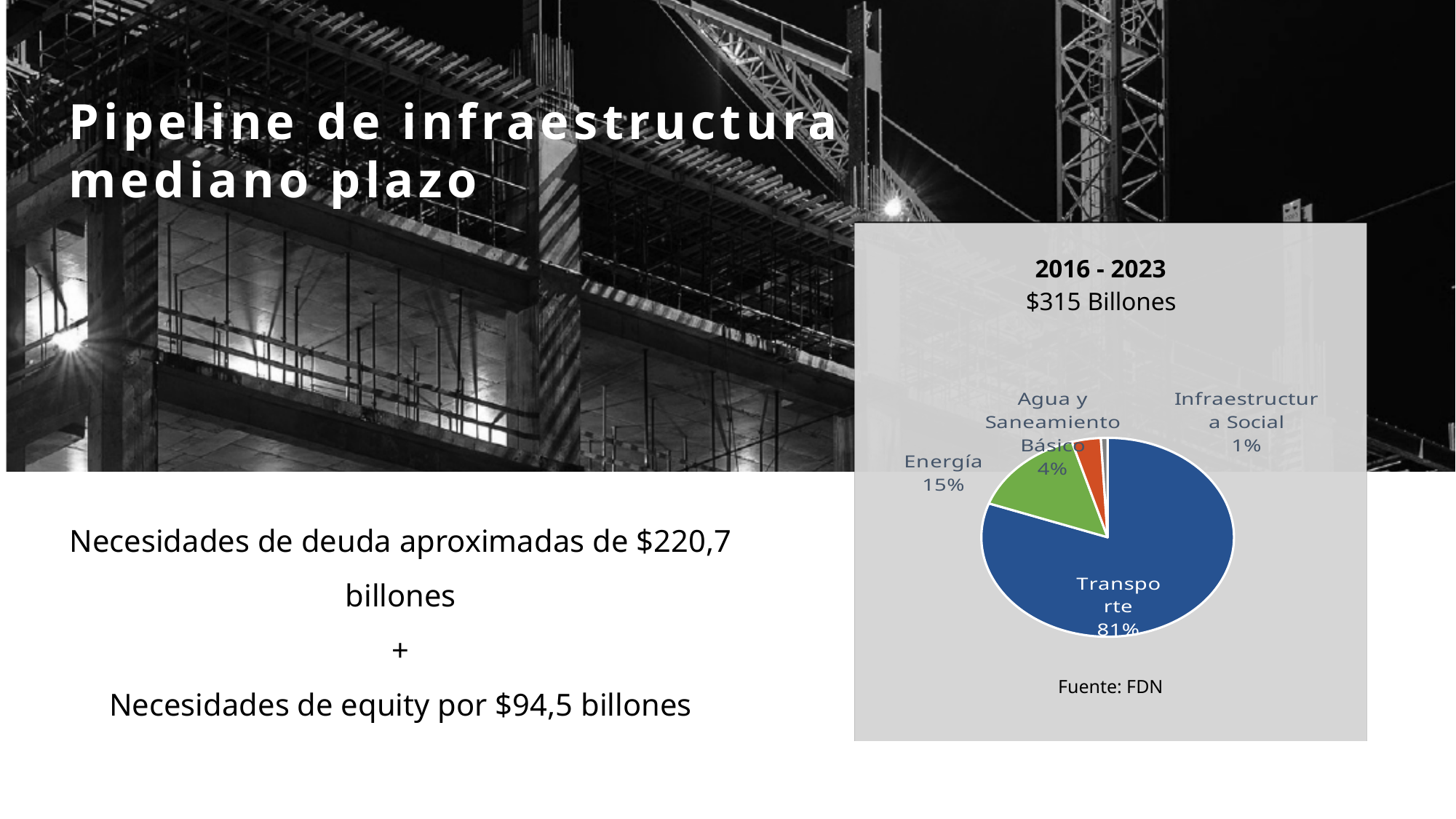
What kind of chart is shown on the slide? Pie chart What share of the pie does Infraestructura Social represent? 1% How many categories are shown in the pie chart? 4 What share of the pie does Agua y Saneamiento Básico represent? 4% Which is larger, the share for Energía or the share for Agua y Saneamiento Básico? Energía Which category has the smallest slice of the pie? Infraestructura Social Which category has the largest slice of the pie? Transporte What share of the pie does Energía represent? 15% What is the difference in percentage points between Transporte and Energía? 66 What period and total amount are given in the chart title? 2016 - 2023, $315 Billones What source is cited below the pie chart? FDN